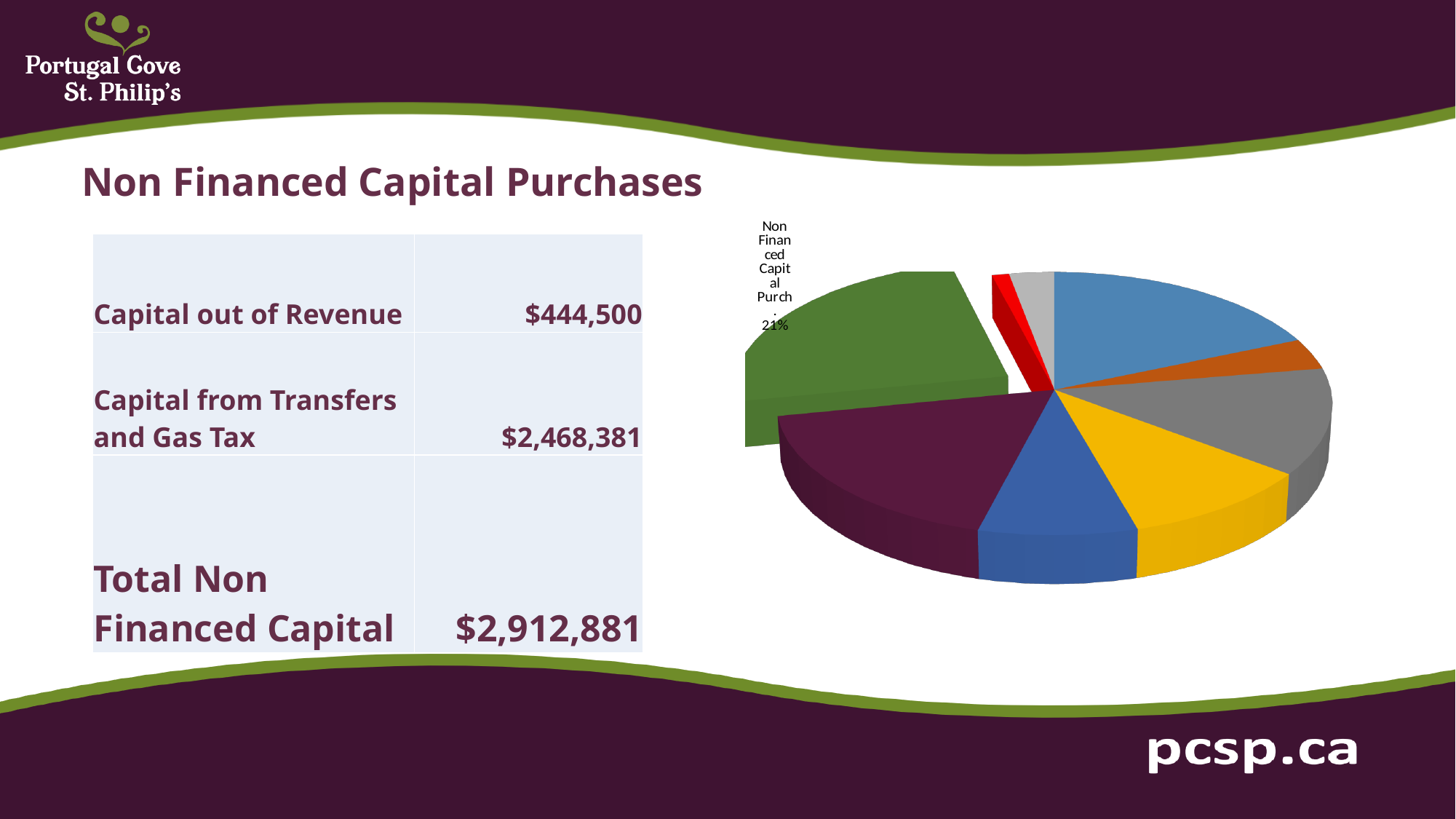
What kind of chart is shown on the right of the slide? pie chart Is the share for Non Financed Capital Purchases greater or less than 20%? greater What colour is the slice labelled Non Financed Capital Purchases? green What share of the pie does the Non Financed Capital Purchases slice represent? 21% How many slices does the pie chart have? 9 Which slice is pulled out (exploded) from the pie chart? Non Financed Capital Purchases